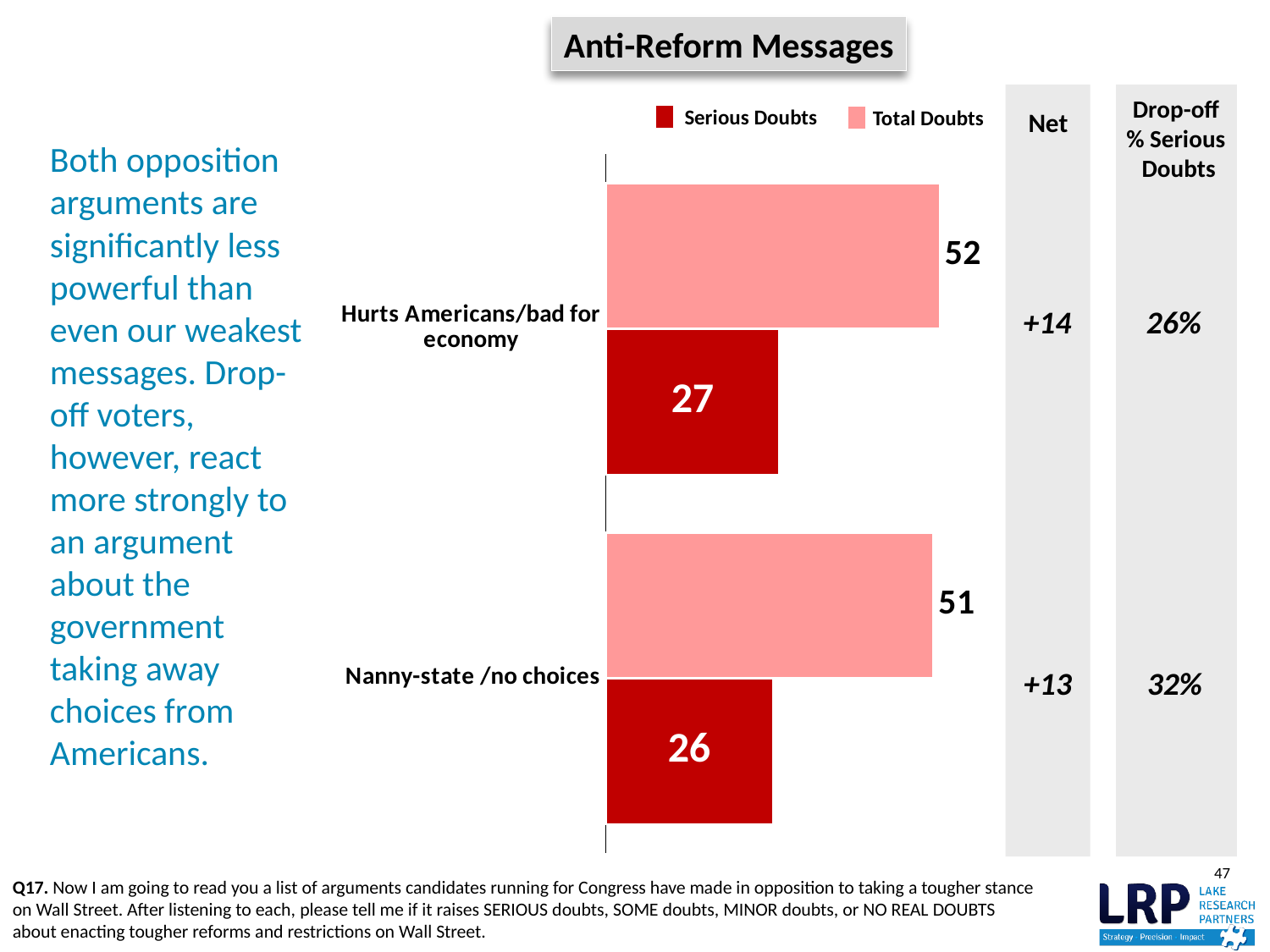
How many series does the legend list? 2 What is the Serious Doubts value for "Hurts Americans/bad for economy"? 27 How many categories are shown in the chart? 2 What is the Total Doubts value for "Hurts Americans/bad for economy"? 52 Which series is shown in dark red in the legend? Serious Doubts What is the title of the chart? Anti-Reform Messages What is the Serious Doubts value for "Nanny-state /no choices"? 26 Which category has the higher Total Doubts value? Hurts Americans/bad for economy What is the difference between Total Doubts and Serious Doubts for "Hurts Americans/bad for economy"? 25 What is the Total Doubts value for "Nanny-state /no choices"? 51 What kind of chart is shown on the slide? Bar chart What is the difference between Total Doubts and Serious Doubts for "Nanny-state /no choices"? 25